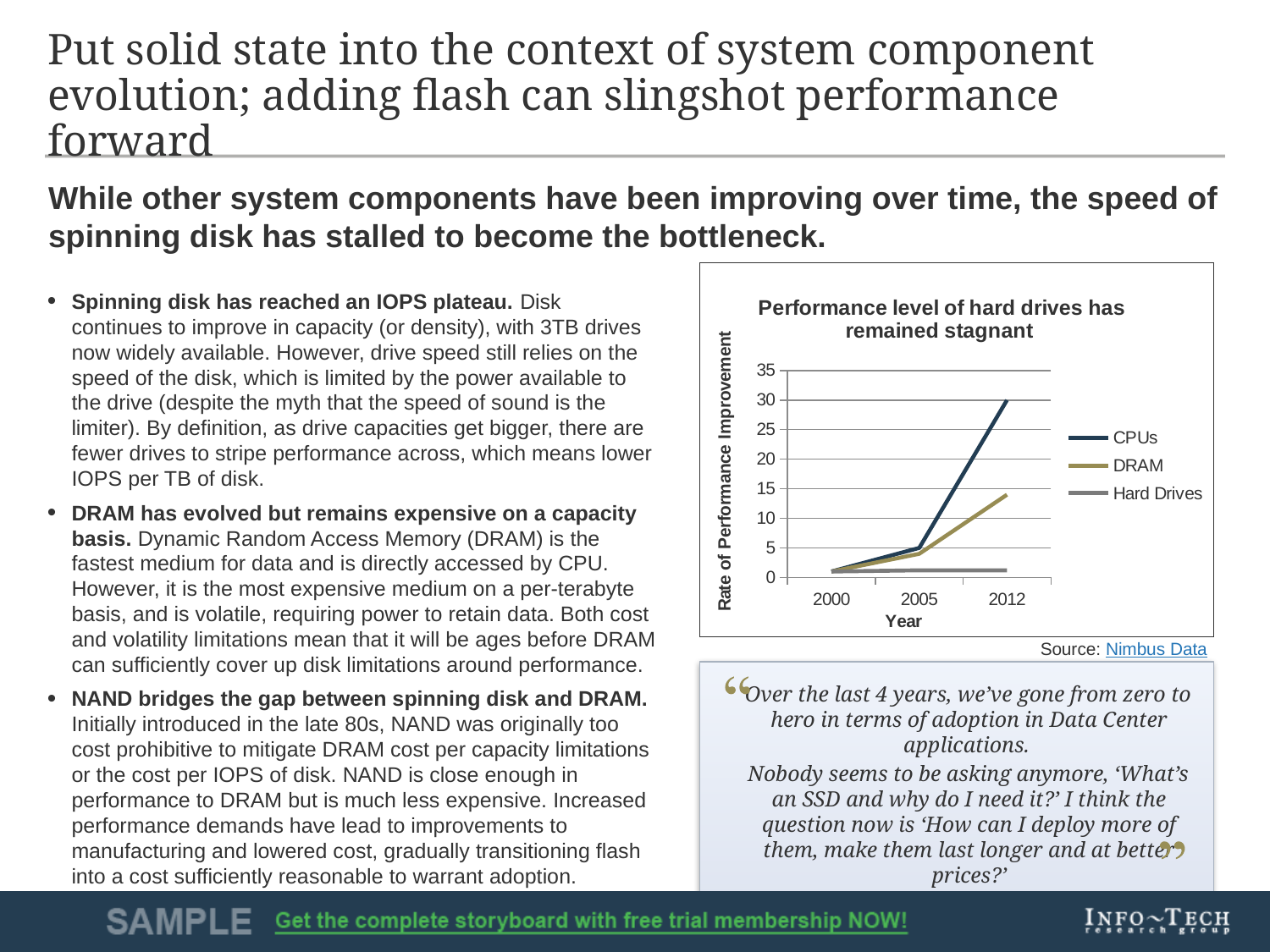
How many years are marked on the x axis of the chart? 3 Do the values for CPUs rise or fall from 2000 to 2012? rise Is the value for CPUs in 2012 greater or less than 25? greater Is the value for DRAM in 2012 greater or less than 10? greater Which series has the lowest value in 2012? Hard Drives Is the value for Hard Drives in 2012 greater or less than 5? less Which series has the highest value in 2012? CPUs What is the title of the chart? Performance level of hard drives has remained stagnant How many series does the chart's legend list? 3 What is the label of the chart's y axis? Rate of Performance Improvement In 2012, which is larger: the value for CPUs or the value for DRAM? CPUs What kind of chart is shown on the slide? line chart